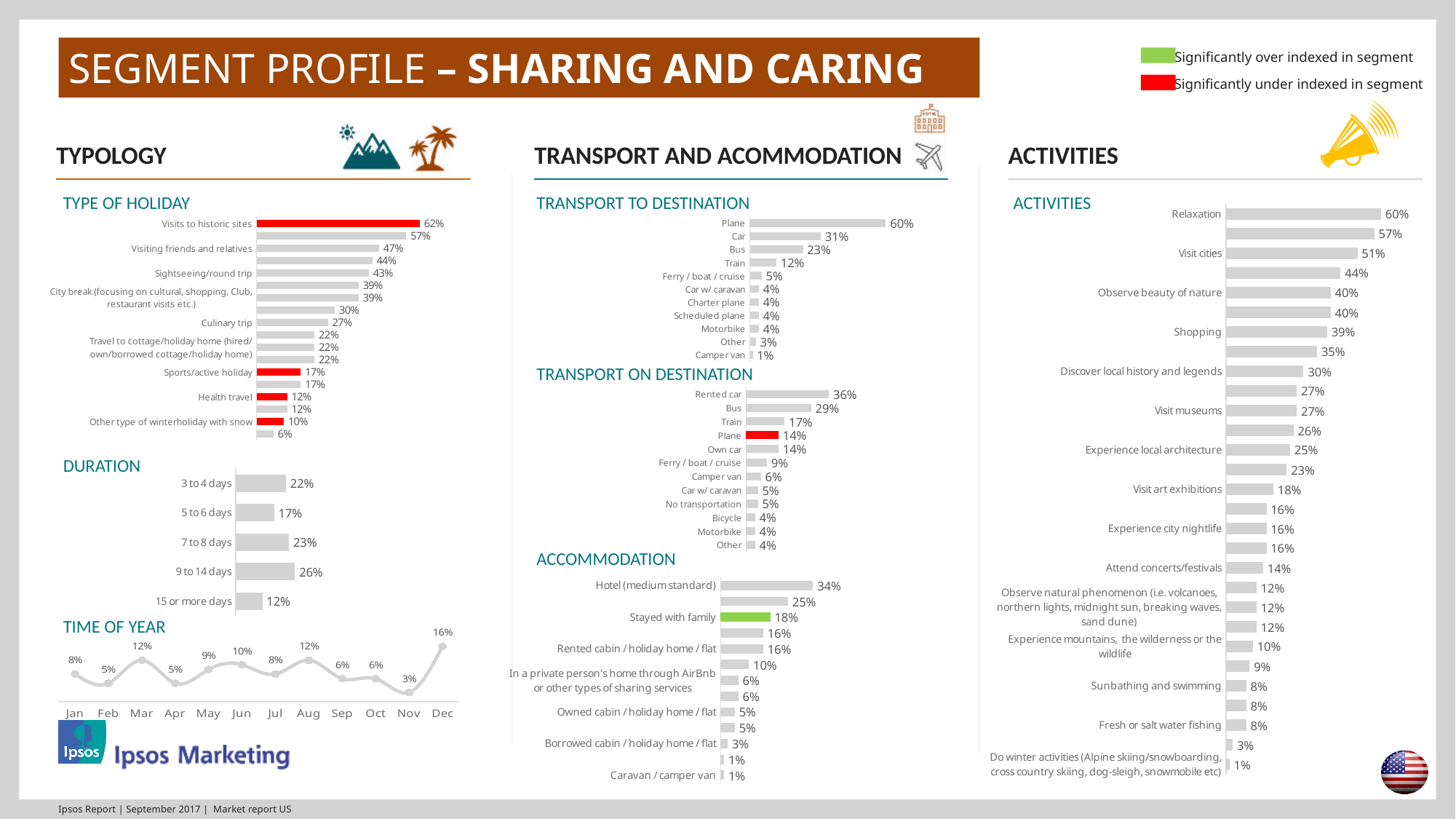
In the Time of Year chart, which month has the highest value? Dec In the Type of Holiday chart, what is the value for Visits to historic sites? 62% In the Duration chart, which category has the lowest value? 15 or more days In the Transport to Destination chart, which is larger, Car or Bus? Car In the Duration chart, which category has the highest value? 9 to 14 days In the Transport on Destination chart, what is the difference between Rented car and Bus? 7 percentage points In the Accommodation chart, what is the value for Stayed with family? 18% In the Time of Year chart, what is the value for Nov? 3% How many categories are shown in the Duration chart? 5 In the Activities chart, what is the value for Relaxation? 60% In the Transport to Destination chart, what is the value for Plane? 60% What kind of chart is the Time of Year chart? Line chart